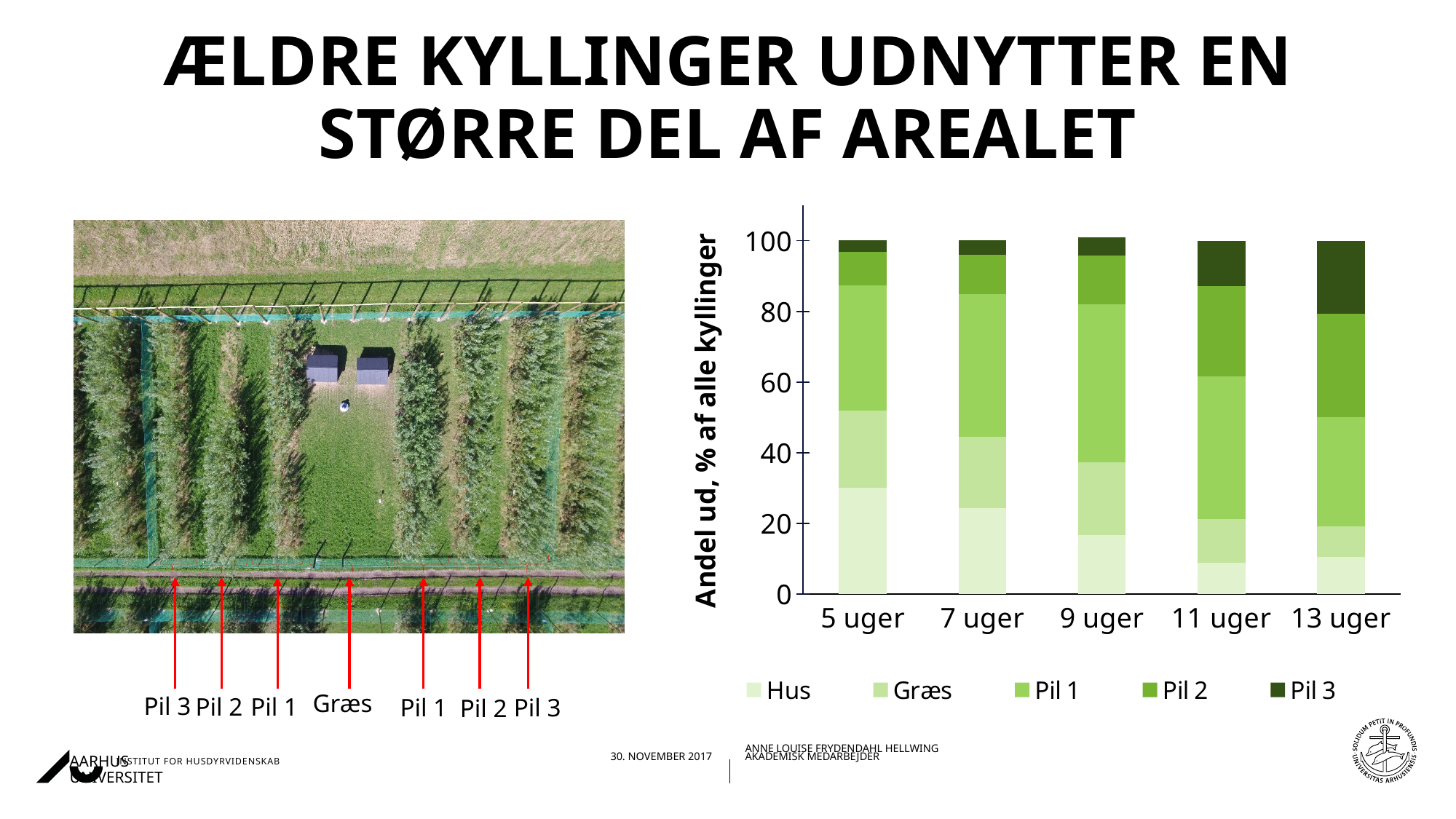
Which age category has the largest Pil 3 segment? 13 uger What kind of chart is shown on the slide? stacked bar chart Is the value for Hus at 13 uger greater or less than 20? less Which is larger, the Hus segment at 5 uger or the Hus segment at 13 uger? 5 uger Is the value for Hus at 5 uger greater or less than 20? greater How many age categories are shown on the x axis of the chart? 5 Does the Hus segment rise or fall as the age increases from 5 uger to 13 uger? fall Which age category has the largest Hus segment? 5 uger What is the title of the y axis of the chart? Andel ud, % af alle kyllinger How many series does the chart legend list? 5 Is the value for Hus at 11 uger greater or less than 20? less Which series is listed first in the chart legend? Hus